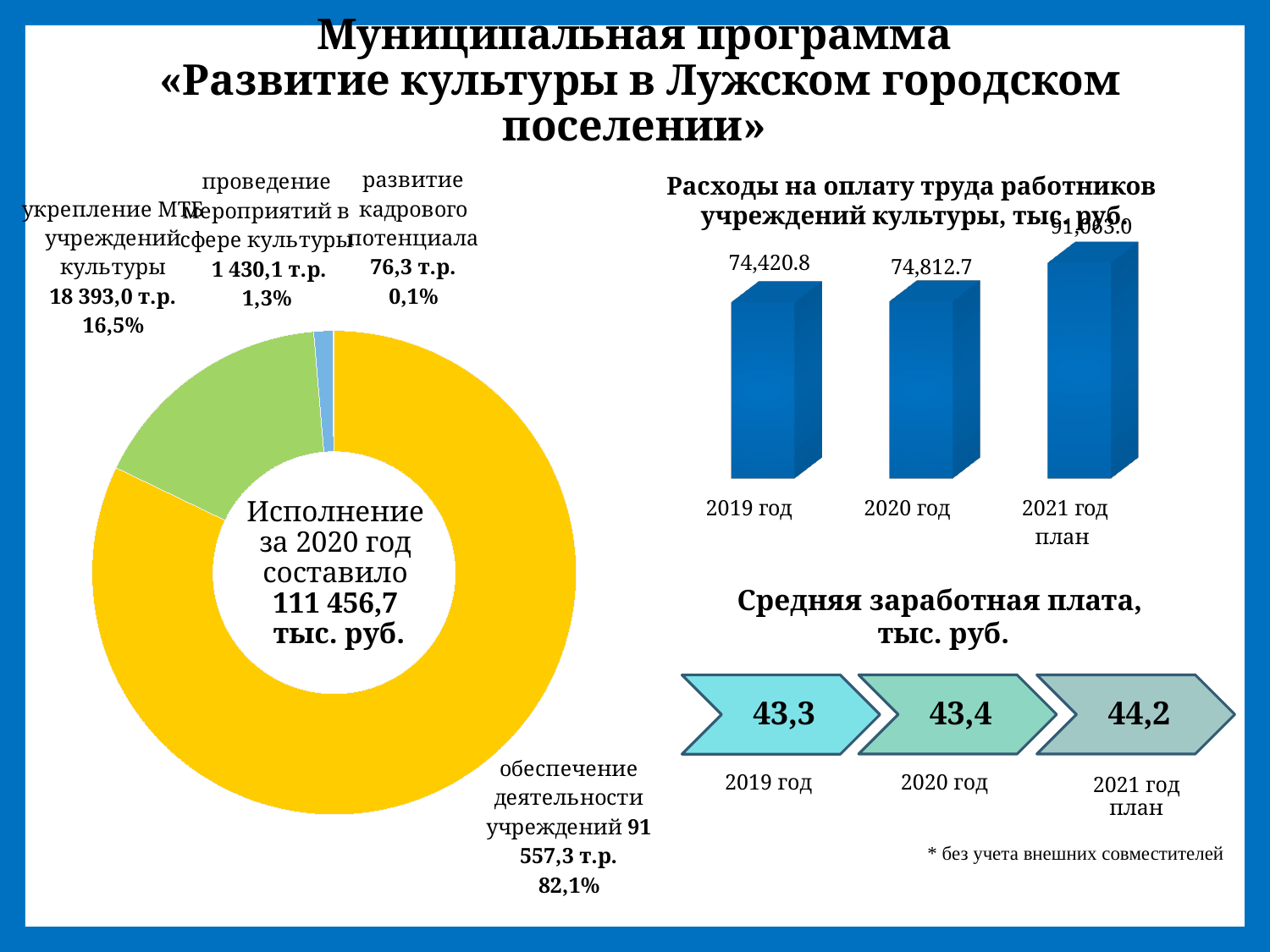
On the donut chart on the left, what is the value for «укрепление МТБ учреждений культуры»? 18 393,0 т.р. On the donut chart on the left, which category has the smallest share? развитие кадрового потенциала On the chart «Расходы на оплату труда работников учреждений культуры, тыс. руб.», do the values rise or fall from 2019 to 2021? Rise On the chart «Расходы на оплату труда работников учреждений культуры, тыс. руб.», what is the value for 2020 год? 74,812.7 On the donut chart on the left, what share does «обеспечение деятельности учреждений» have? 82,1% On the donut chart on the left, which category has the largest share? обеспечение деятельности учреждений On the chart «Расходы на оплату труда работников учреждений культуры, тыс. руб.», what is the value for 2019 год? 74,420.8 On the chart «Расходы на оплату труда работников учреждений культуры, тыс. руб.», what is the difference between 2020 год and 2019 год? 391.9 What kind of chart is the chart on the left of the slide? Donut (pie) chart On the chart «Расходы на оплату труда работников учреждений культуры, тыс. руб.», which year has the highest value? 2021 год план What total is shown in the centre of the donut chart on the left? 111 456,7 тыс. руб. How many categories are shown on the donut chart on the left? 4